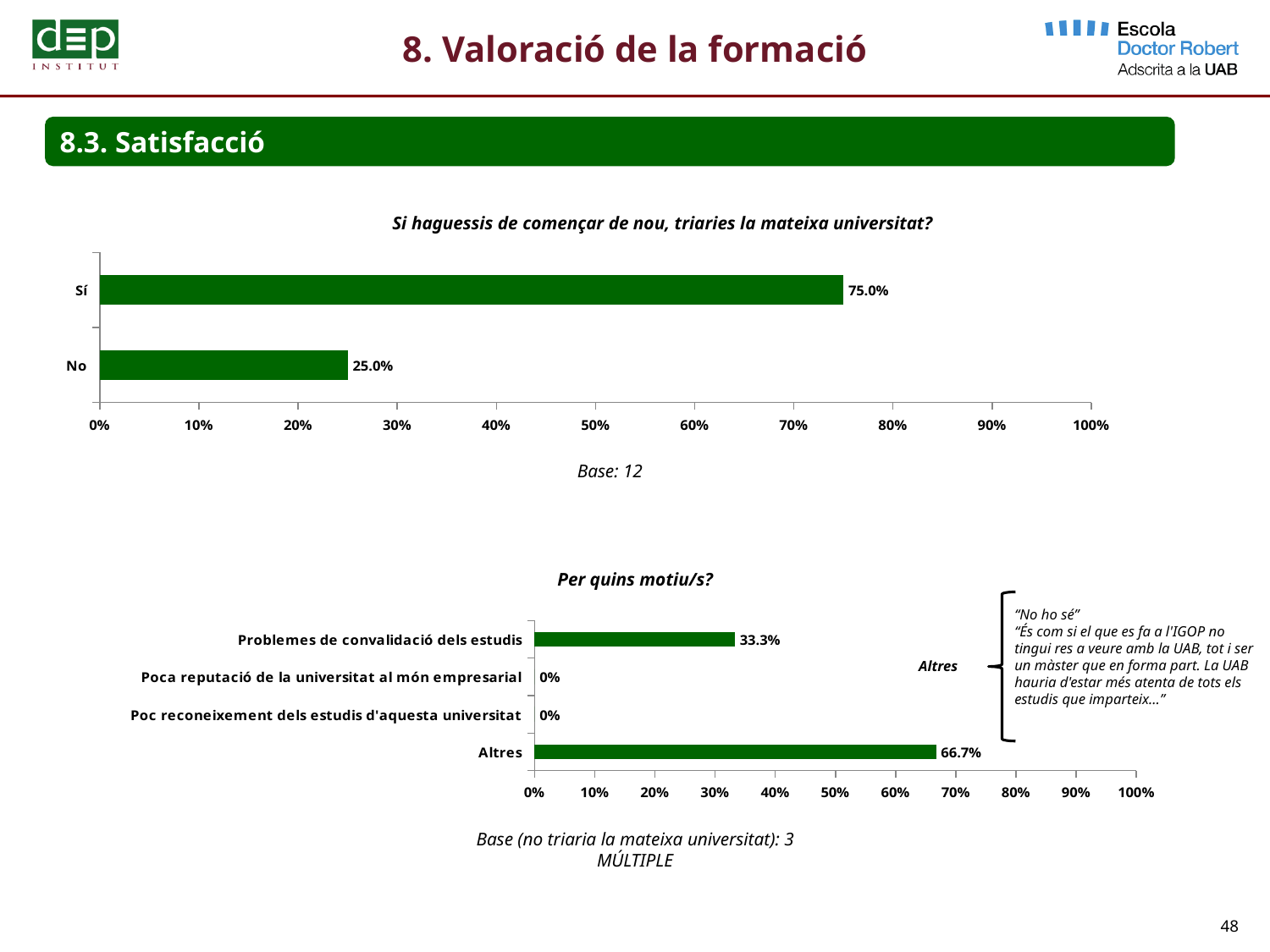
What kind of chart is the top chart 'Si haguessis de començar de nou, triaries la mateixa universitat?'? Bar chart In the top chart 'Si haguessis de començar de nou, triaries la mateixa universitat?', how many categories are shown? 2 In the top chart 'Si haguessis de començar de nou, triaries la mateixa universitat?', what is the difference between the values for 'Sí' and 'No'? 50.0% In the bottom chart 'Per quins motiu/s?', which is larger: 'Altres' or 'Problemes de convalidació dels estudis'? Altres In the top chart 'Si haguessis de començar de nou, triaries la mateixa universitat?', what is the value for 'No'? 25.0% In the bottom chart 'Per quins motiu/s?', which category has the highest value? Altres In the bottom chart 'Per quins motiu/s?', what is the value for 'Poca reputació de la universitat al món empresarial'? 0% In the bottom chart 'Per quins motiu/s?', what is the value for 'Problemes de convalidació dels estudis'? 33.3% In the bottom chart 'Per quins motiu/s?', what is the difference between 'Altres' and 'Problemes de convalidació dels estudis'? 33.4% In the bottom chart 'Per quins motiu/s?', how many categories are shown? 4 In the top chart 'Si haguessis de començar de nou, triaries la mateixa universitat?', what is the value for 'Sí'? 75.0% In the bottom chart 'Per quins motiu/s?', what is the value for 'Altres'? 66.7%